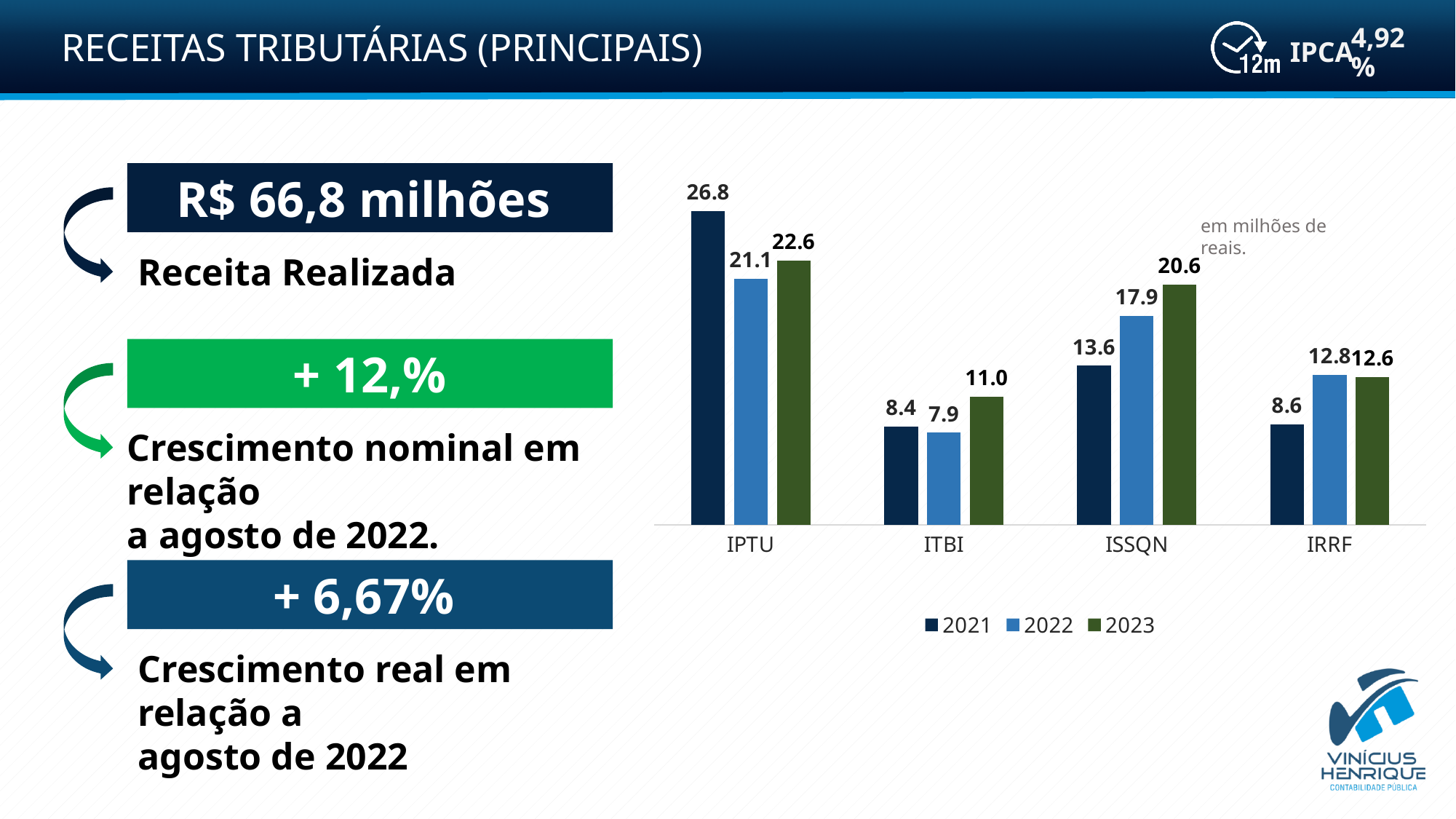
Which is larger for ISSQN: the 2022 value or the 2023 value? 2023 What is the difference between the 2021 and 2023 values for IPTU? 4.2 What is the value for IRRF in 2022? 12.8 What is the value for ISSQN in 2023? 20.6 Which category has the lowest value in 2023? ITBI Which category has the highest value in 2021? IPTU Do the values for ISSQN rise or fall from 2021 to 2023? rise How many series does the legend list? 3 What is the value for ITBI in 2022? 7.9 What kind of chart is shown on the slide? bar chart How many categories are shown on the x axis? 4 What is the value for IPTU in 2021? 26.8